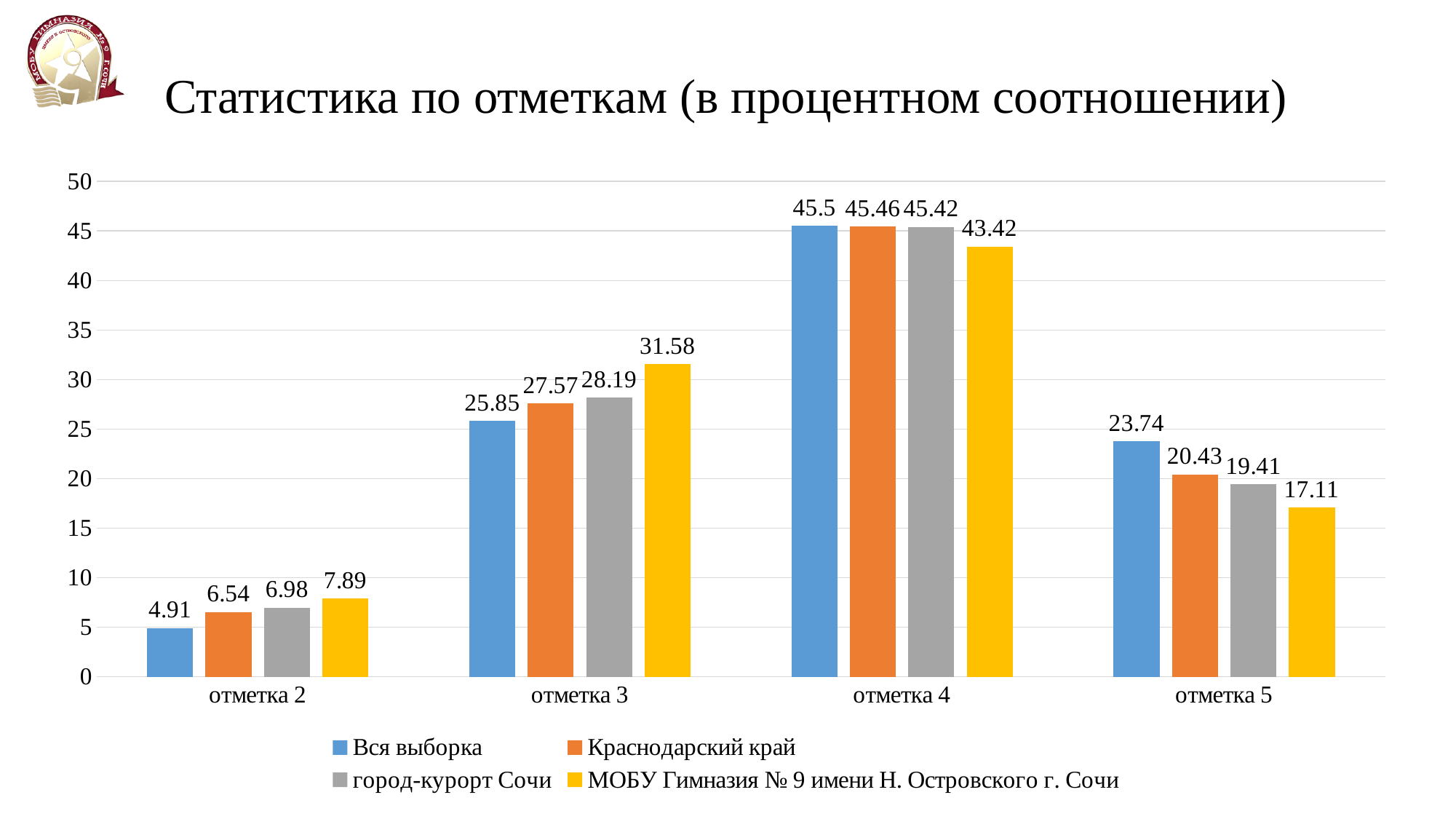
Which category has the highest value for the Вся выборка series? отметка 4 What is the value for МОБУ Гимназия № 9 имени Н. Островского г. Сочи at отметка 3? 31.58 What is the value for Вся выборка at отметка 2? 4.91 How many series does the legend list? 4 What kind of chart is shown on the slide? bar chart What is the value for город-курорт Сочи at отметка 5? 19.41 What is the title of the slide? Статистика по отметкам (в процентном соотношении) What is the value for Краснодарский край at отметка 4? 45.46 What is the difference between the Вся выборка and МОБУ Гимназия № 9 имени Н. Островского г. Сочи values at отметка 5? 6.63 How many categories are shown on the x axis? 4 Which category has the lowest value for the МОБУ Гимназия № 9 имени Н. Островского г. Сочи series? отметка 2 At отметка 3, which is larger: the value for Краснодарский край or the value for город-курорт Сочи? город-курорт Сочи